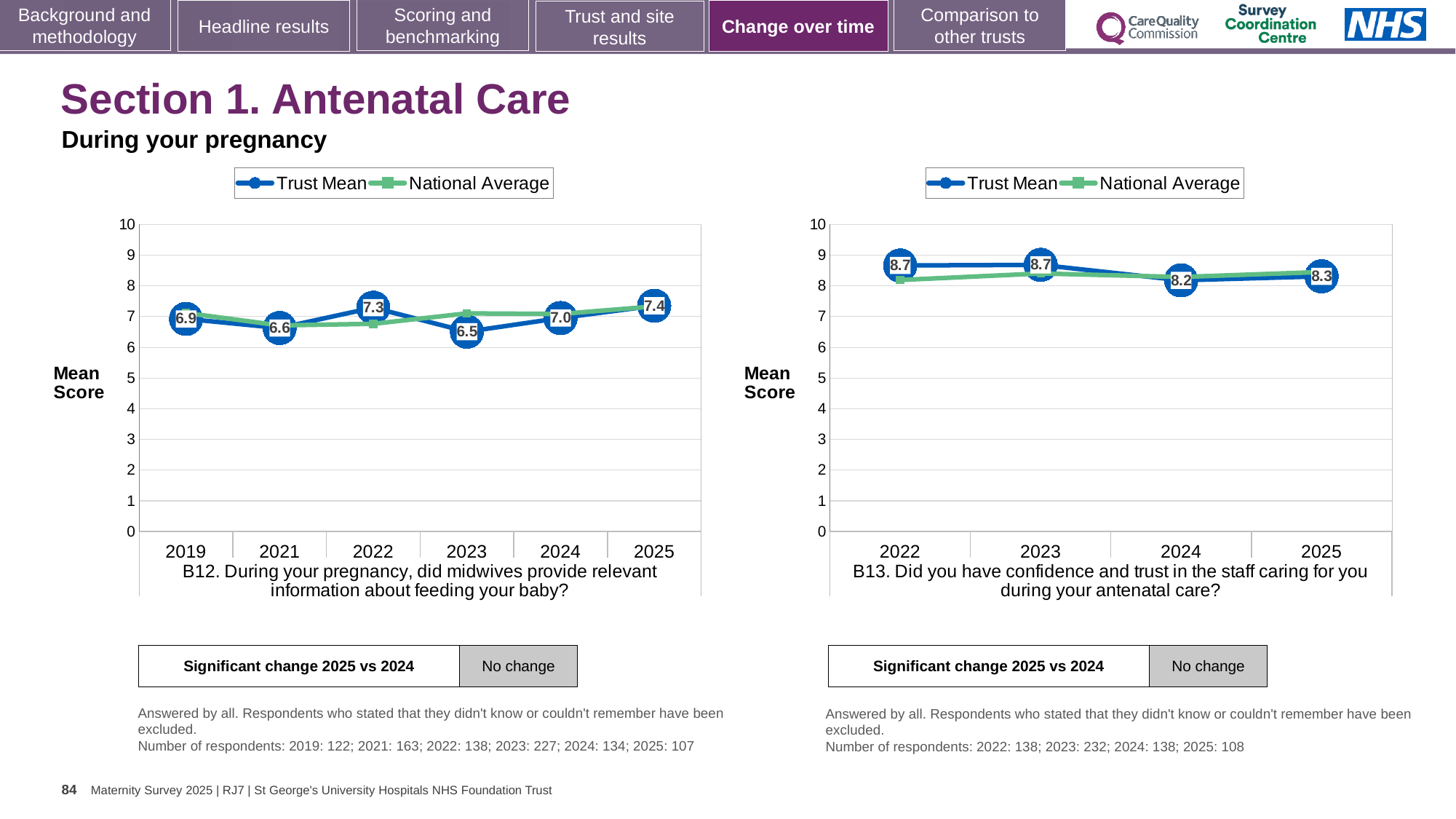
In the B12 chart on the left, what is the difference between the Trust Mean scores for 2022 and 2023? 0.8 In the B12 chart on the left, which year has the highest Trust Mean score? 2025 In the B12 chart on the left, what is the Trust Mean score for 2023? 6.5 In the B13 chart on the right, does the Trust Mean score rise or fall from 2023 to 2024? Fall In the B13 chart on the right, what is the Trust Mean score for 2024? 8.2 How many years are plotted on the x axis of the B12 chart on the left? 6 In the B12 chart on the left, what is the Trust Mean score for 2025? 7.4 In the B13 chart on the right, is the Trust Mean score for 2022 or 2025 larger? 2022 What kind of chart is the B12 chart on the left? Line chart In the B13 chart on the right, which year has the lowest Trust Mean score? 2024 In the B13 chart on the right, is the National Average value for 2022 greater or less than 8? greater How many series does the legend of the B13 chart on the right list? 2